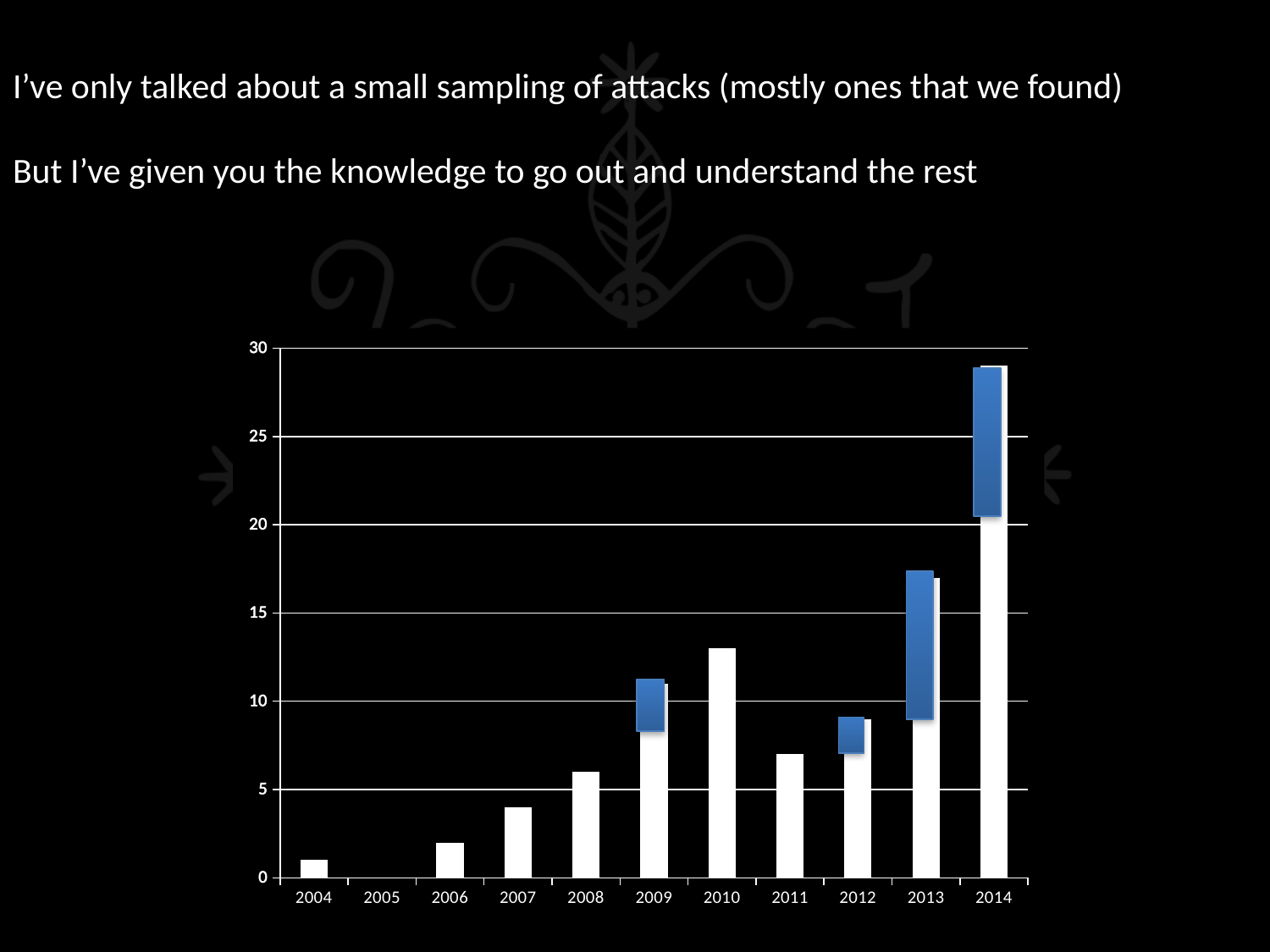
Do the values generally rise or fall from 2004 to 2014? rise Which year has the lowest value in the chart? 2005 Which is larger, the value for 2013 or the value for 2012? 2013 Is the value for 2014 greater or less than 25? greater Is the value for 2007 greater or less than 5? less Is the value for 2010 greater or less than 10? greater What kind of chart is shown on the slide? bar chart Which is larger, the value for 2010 or the value for 2011? 2010 Which year has the highest bar in the chart? 2014 How many years are shown on the x axis of the chart? 11